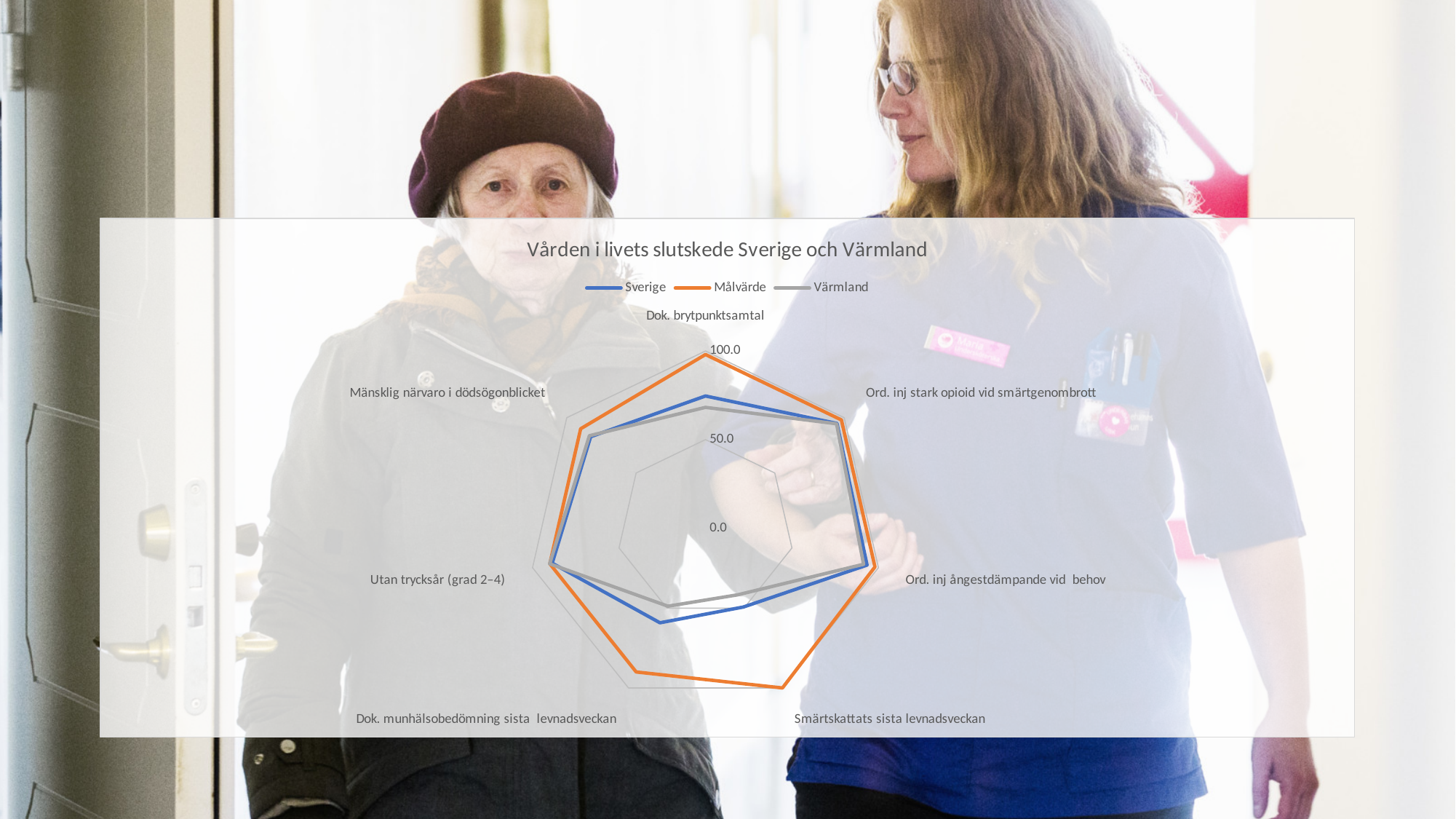
For Dok. brytpunktsamtal, which is larger: the Målvärde value or the Sverige value? Målvärde Is the Sverige value for Dok. brytpunktsamtal greater or less than 50.0? greater Which series are listed in the legend? Sverige, Målvärde, Värmland How many categories (axes) does the radar chart have? 7 For Dok. munhälsobedömning sista levnadsveckan, which is larger: the Målvärde value or the Värmland value? Målvärde What is the title of the chart? Vården i livets slutskede Sverige och Värmland What kind of chart is shown on the slide? Radar chart Is the Målvärde value for Dok. brytpunktsamtal greater or less than 50.0? greater How many series does the legend list? 3 For Smärtskattats sista levnadsveckan, which is larger: the Målvärde value or the Sverige value? Målvärde Is the Sverige value for Utan trycksår (grad 2–4) greater or less than 50.0? greater